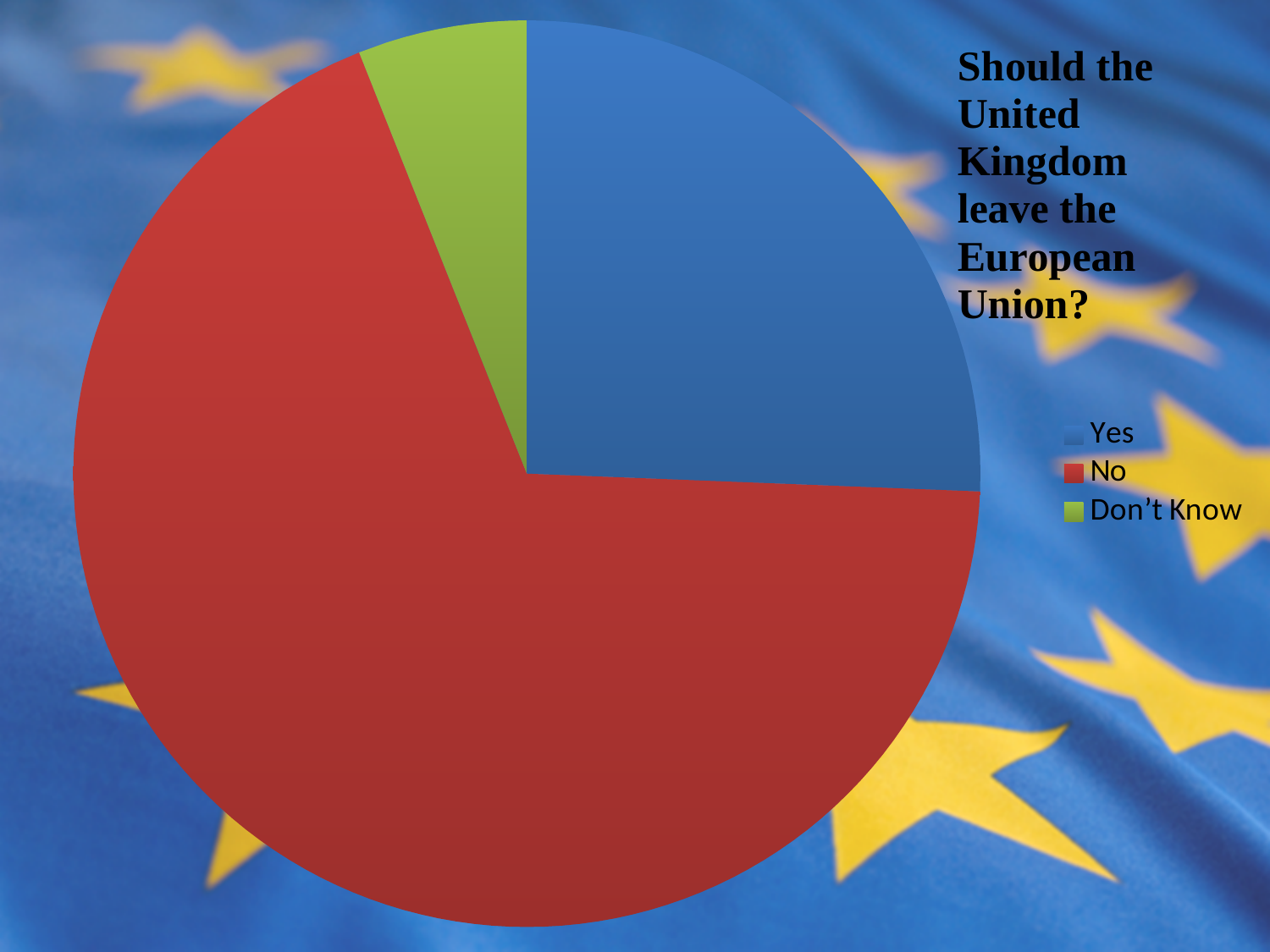
What kind of chart is shown on the slide? pie chart How many slices does the pie chart have? 3 Which slice is smaller, No or Don't Know? Don't Know What question does the chart's title ask? Should the United Kingdom leave the European Union? Which slice is larger, Yes or Don't Know? Yes Which slice is larger, Yes or No? No What colour is the No slice in the pie chart? red How many entries does the legend list? 3 Which category has the smallest slice of the pie? Don't Know Which category has the largest slice of the pie? No